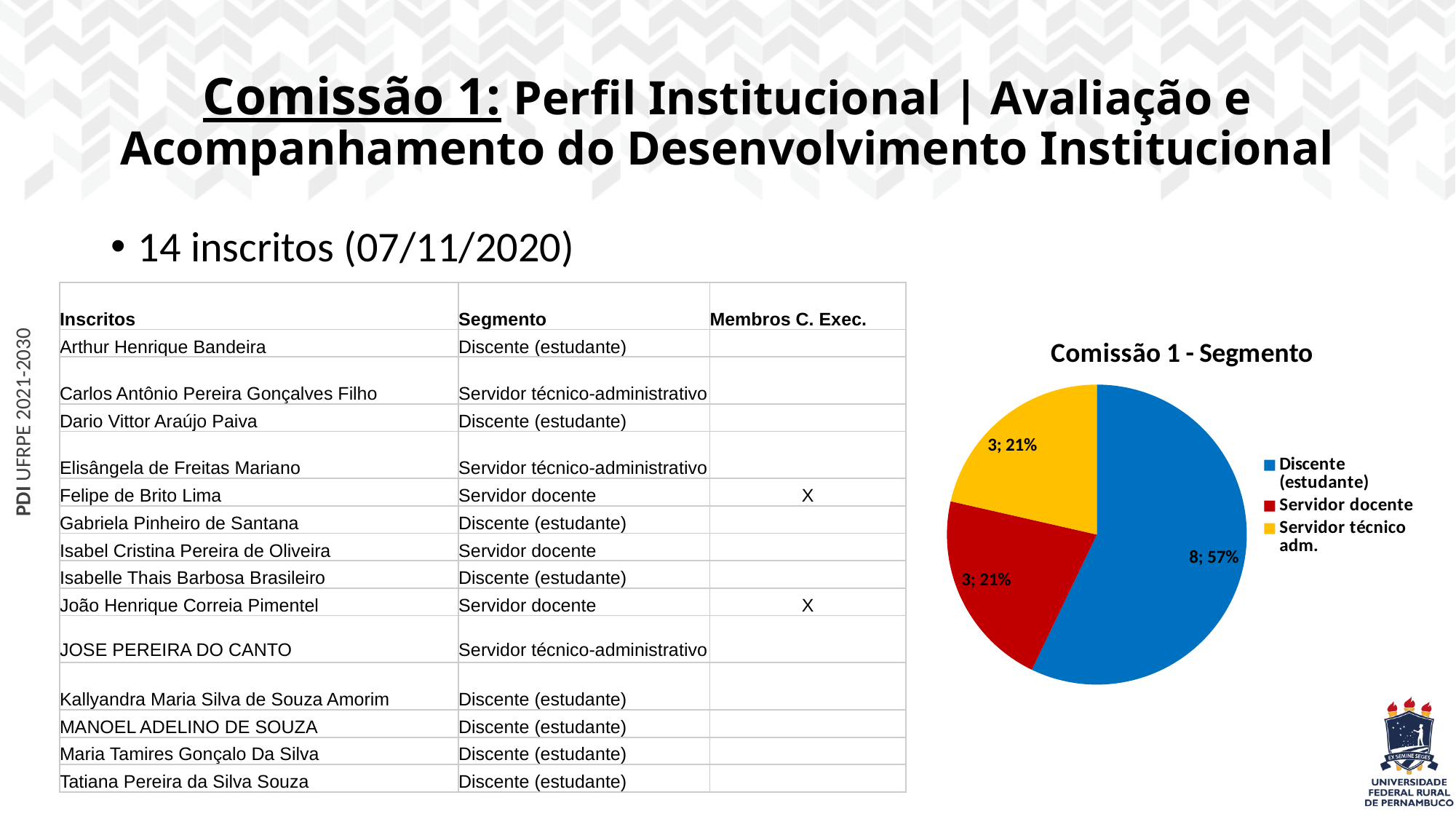
Which is larger in the pie chart: Discente (estudante) or Servidor técnico adm.? Discente (estudante) What is the count shown for Servidor docente in the pie chart? 3 What is the count shown for Discente (estudante) in the pie chart? 8 What is the difference in count between Discente (estudante) and Servidor docente? 5 What kind of chart is shown on the slide? pie chart How many slices does the pie chart have? 3 What is the title of the chart? Comissão 1 - Segmento What percentage share does Servidor técnico adm. have in the pie chart? 21% How many entries does the chart legend list? 3 What percentage share does Discente (estudante) have in the pie chart? 57% Which segment has the largest slice in the pie chart? Discente (estudante) What colour is the Servidor docente slice in the pie chart? red